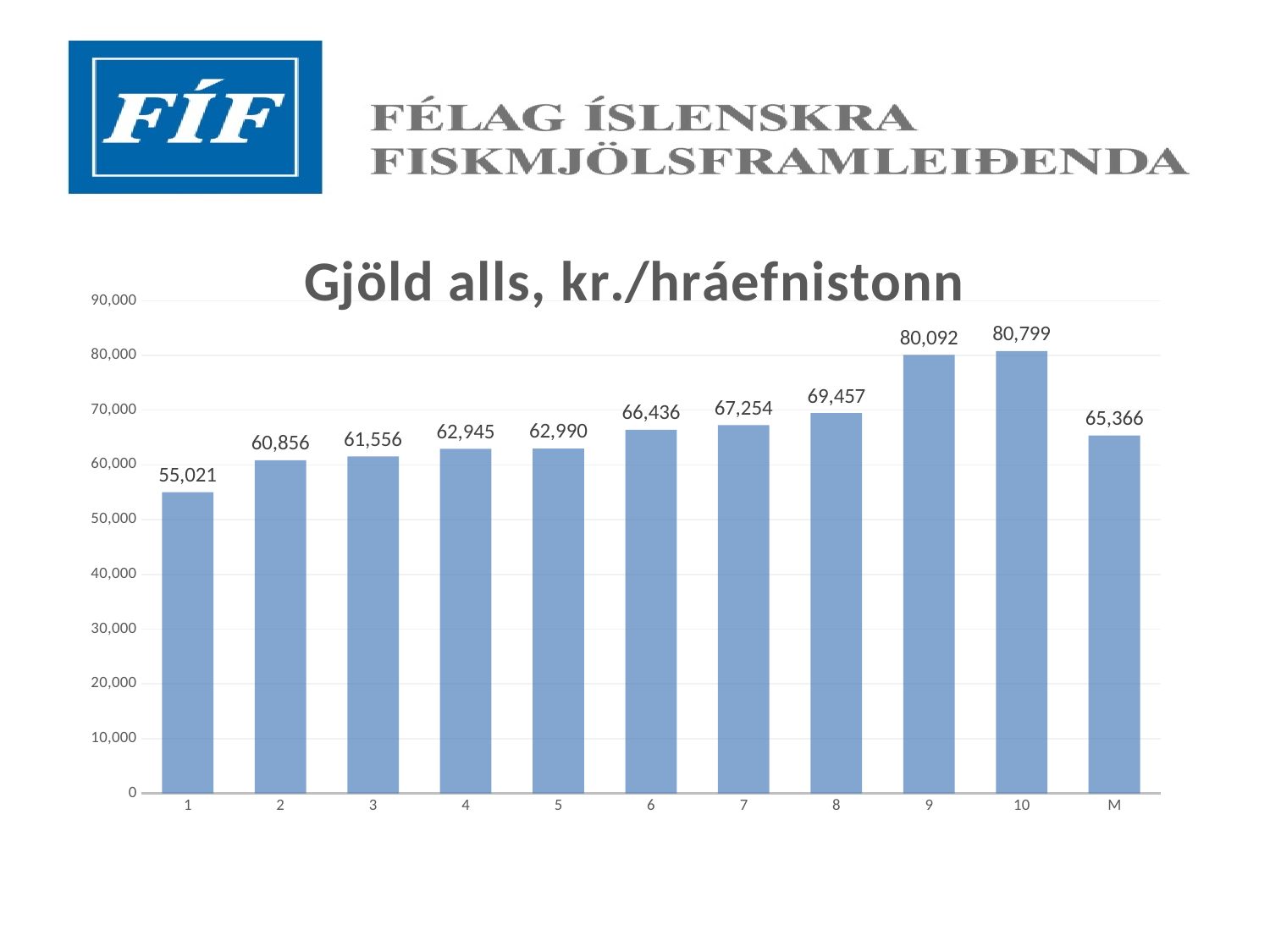
What kind of chart is shown on the slide? bar chart Which category has the lowest value? 1 What is the value for category 7? 67,254 Do the values rise or fall from category 1 to category 10? rise How many bars are shown in the chart? 11 What is the value for category 1? 55,021 What is the value for category M? 65,366 What is the difference between the values for category 10 and category 1? 25,778 Which category has the highest value? 10 Which is larger, the value for category 8 or the value for category M? 8 Is the value for category 9 greater or less than 70,000? greater What is the title of the chart? Gjöld alls, kr./hráefnistonn